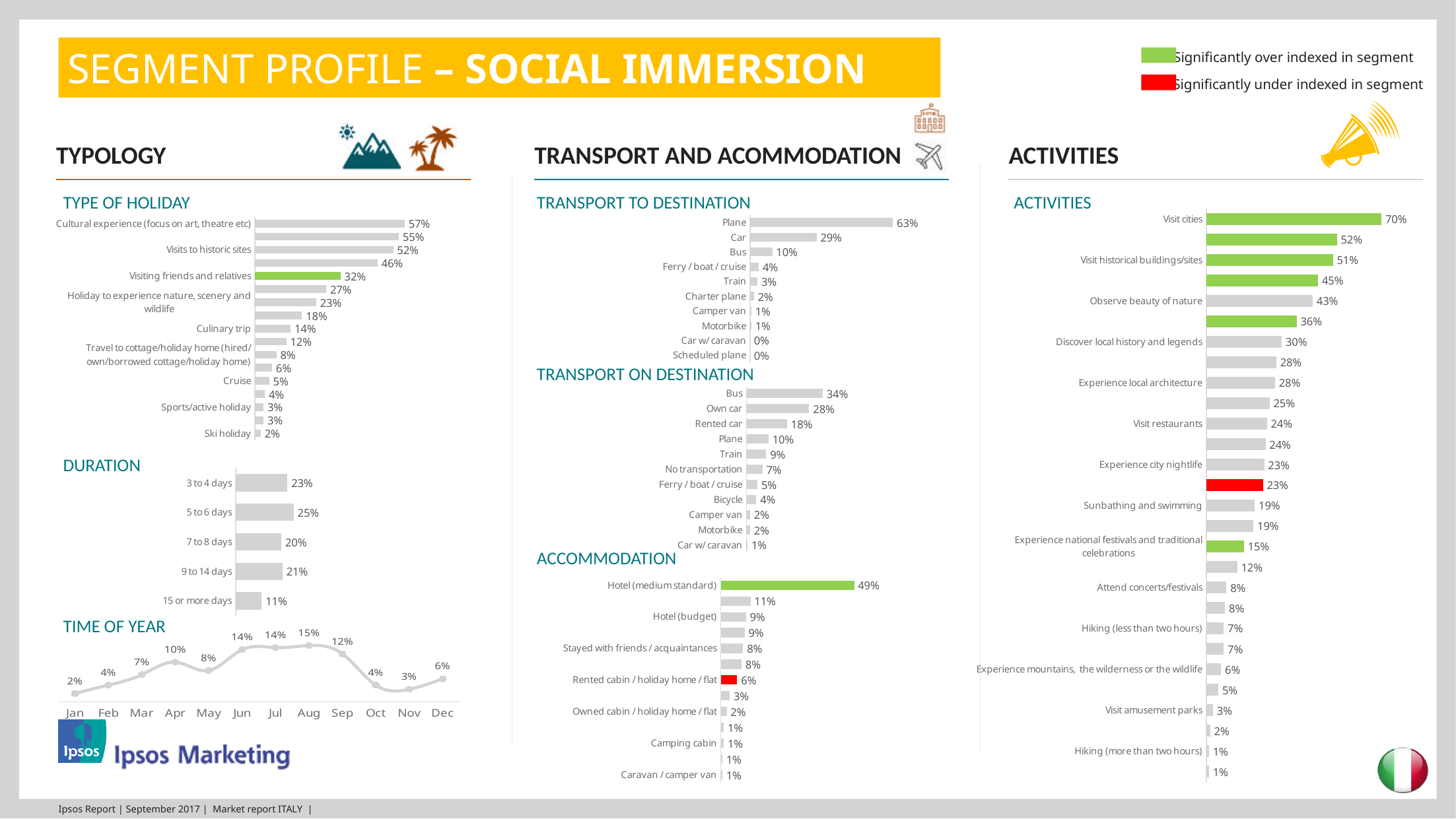
In the Time of Year chart, what is the value for Jan? 2% In the Duration chart, which category has the highest value? 5 to 6 days In the Duration chart, which category has the lowest value? 15 or more days In the Accommodation chart, what is the value for Hotel (medium standard)? 49% What kind of chart is the Time of Year chart? Line chart How many categories are shown in the Duration chart? 5 In the Transport on Destination chart, what is the difference between Bus and Own car? 6 percentage points In the Transport to Destination chart, what is the value for Plane? 63% In the Type of Holiday chart, what is the value for Visiting friends and relatives? 32% In the Time of Year chart, which month has the highest value? Aug In the Transport to Destination chart, which category has the highest value? Plane In the Activities chart, what is the value for Visit cities? 70%